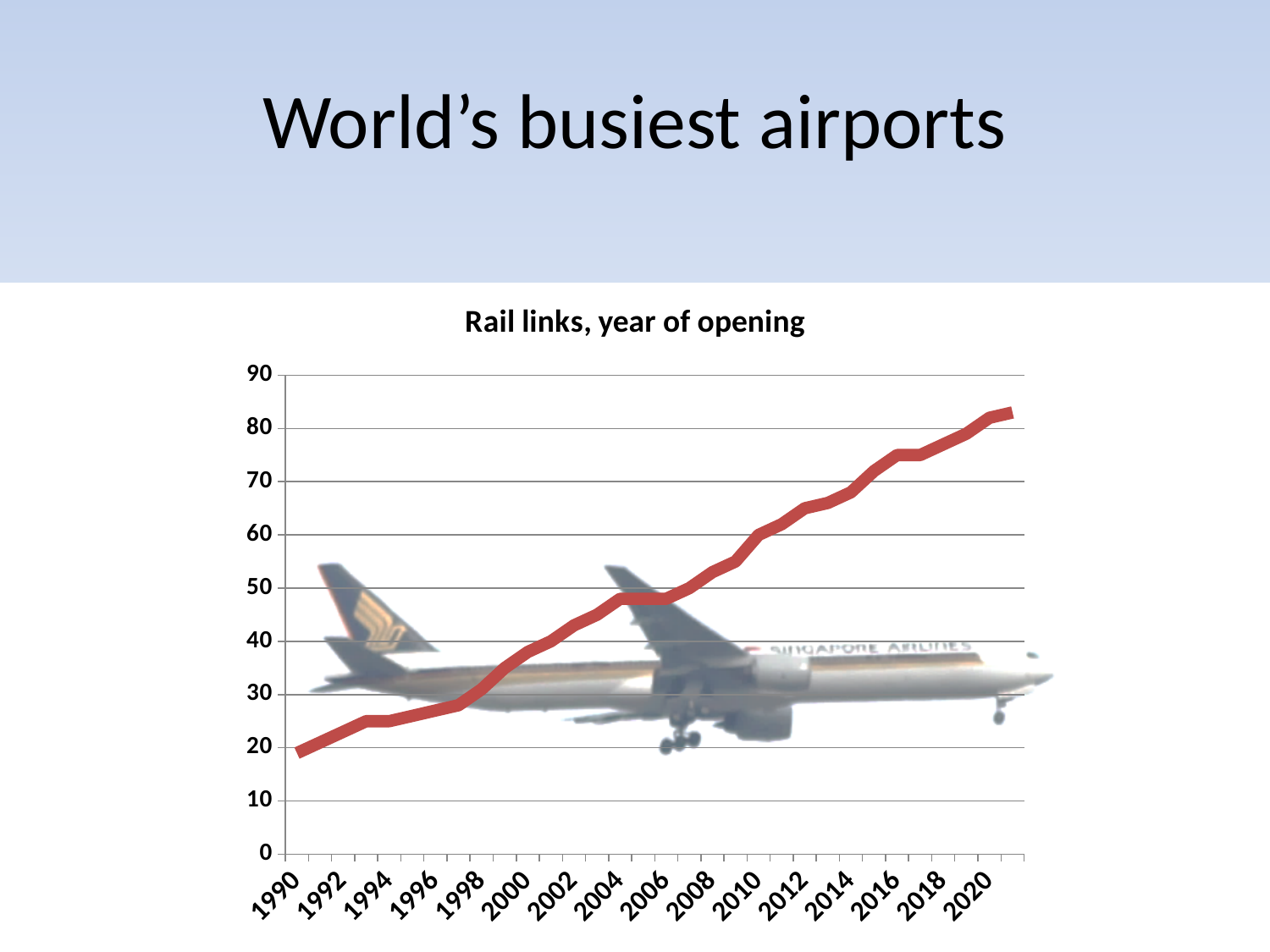
What kind of chart is shown on the slide? line chart What is the highest value shown on the vertical axis? 90 Which year has the larger value, 2000 or 2014? 2014 Is the value for 1990 greater or less than 30? less Is the value for 2020 greater or less than 80? greater What is the title of the chart? Rail links, year of opening Which year has the lowest value on the chart? 1990 Is the value for 2016 greater or less than 70? greater Do the values rise or fall from 1990 to 2020? rise